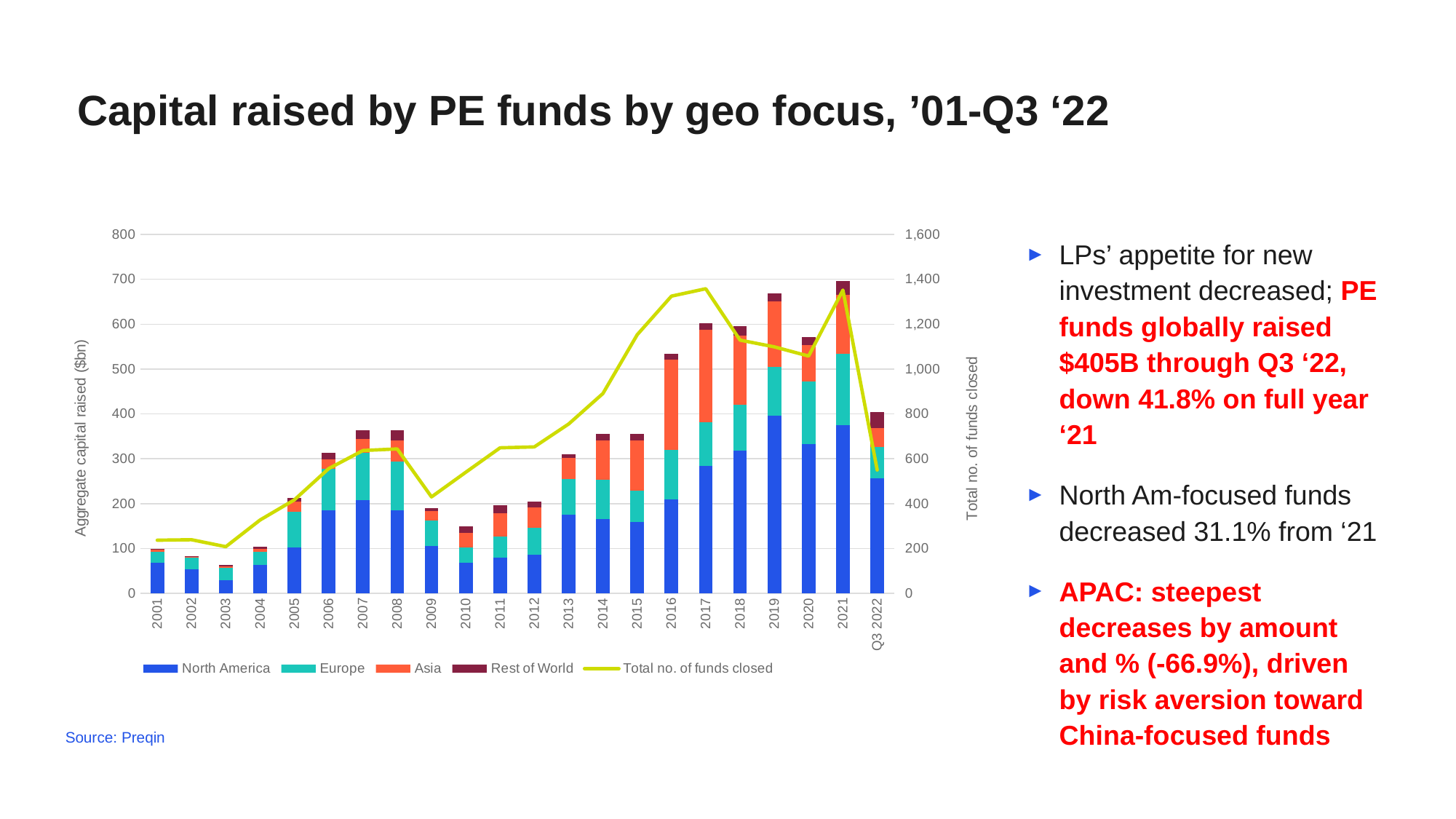
What kind of chart is shown on the slide? A stacked bar chart combined with a line chart Is the total aggregate capital raised in 2003 greater or less than 100? less Which year has the lowest total number of funds closed on the line series? 2003 Does the total aggregate capital raised rise or fall from 2013 to 2017? Rise Which year has the highest total aggregate capital raised (tallest stacked bar)? 2021 Which year has a larger total aggregate capital raised, 2019 or 2020? 2019 Is the total number of funds closed in 2017 greater or less than 1,200? greater How many series does the legend list? 5 How many time periods are shown along the x axis? 22 What is the title of the left vertical axis? Aggregate capital raised ($bn) Which year has the lowest total aggregate capital raised (shortest stacked bar)? 2003 Is the total aggregate capital raised in 2021 greater or less than 600? greater